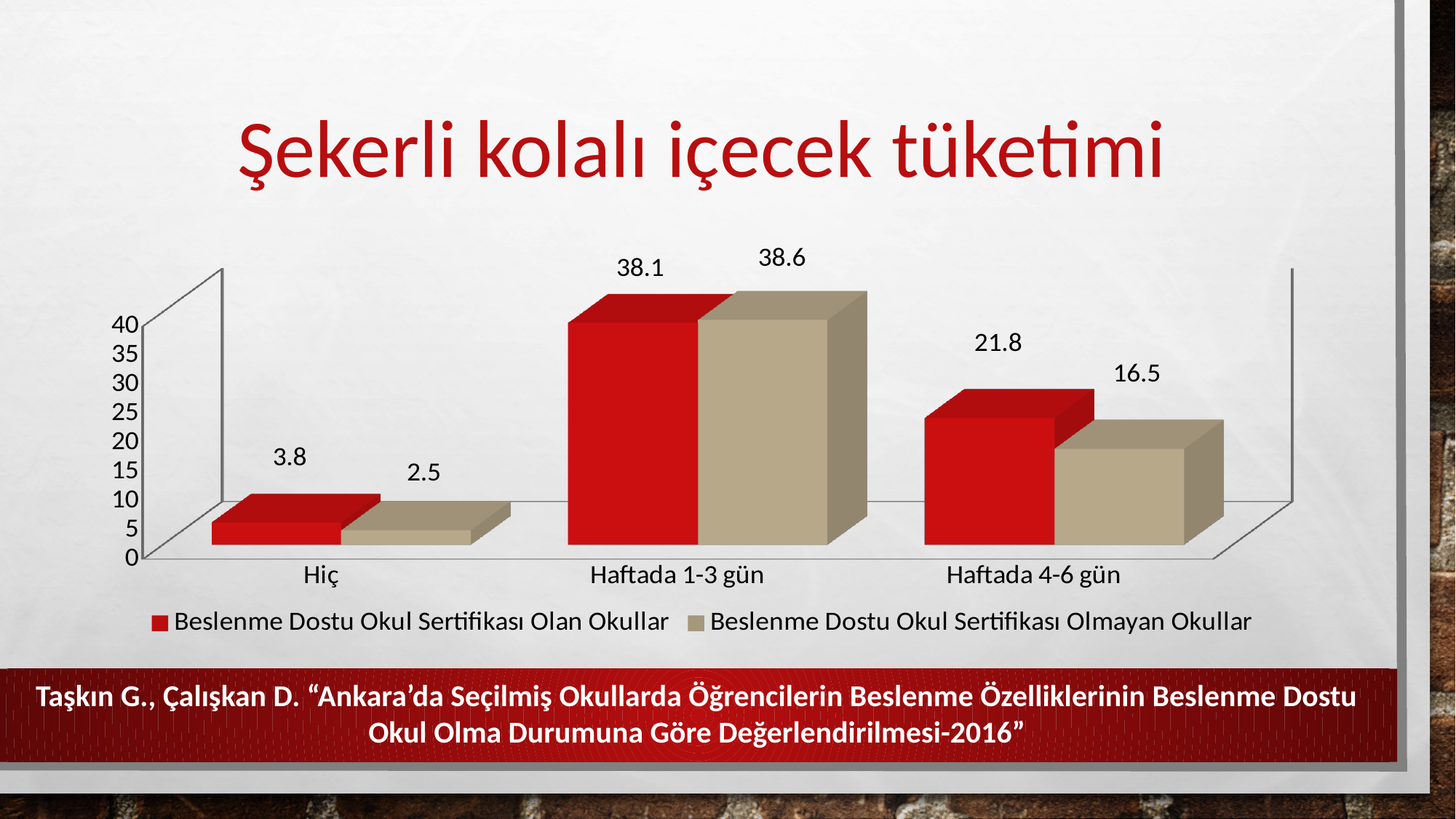
What is the value for 'Beslenme Dostu Okul Sertifikası Olan Okullar' in the 'Hiç' category? 3.8 Which category has the highest value for 'Beslenme Dostu Okul Sertifikası Olan Okullar'? Haftada 1-3 gün In the 'Hiç' category, which series has the larger value? Beslenme Dostu Okul Sertifikası Olan Okullar Which category has the lowest value for 'Beslenme Dostu Okul Sertifikası Olmayan Okullar'? Hiç How many categories are shown on the x axis? 3 What is the value for 'Beslenme Dostu Okul Sertifikası Olan Okullar' in the 'Haftada 4-6 gün' category? 21.8 What is the title of the chart? Şekerli kolalı içecek tüketimi What is the difference between the two series in the 'Haftada 4-6 gün' category? 5.3 What is the value for 'Beslenme Dostu Okul Sertifikası Olmayan Okullar' in the 'Haftada 1-3 gün' category? 38.6 How many series does the legend list? 2 What is the value for 'Beslenme Dostu Okul Sertifikası Olmayan Okullar' in the 'Hiç' category? 2.5 What kind of chart is shown on the slide? Bar chart